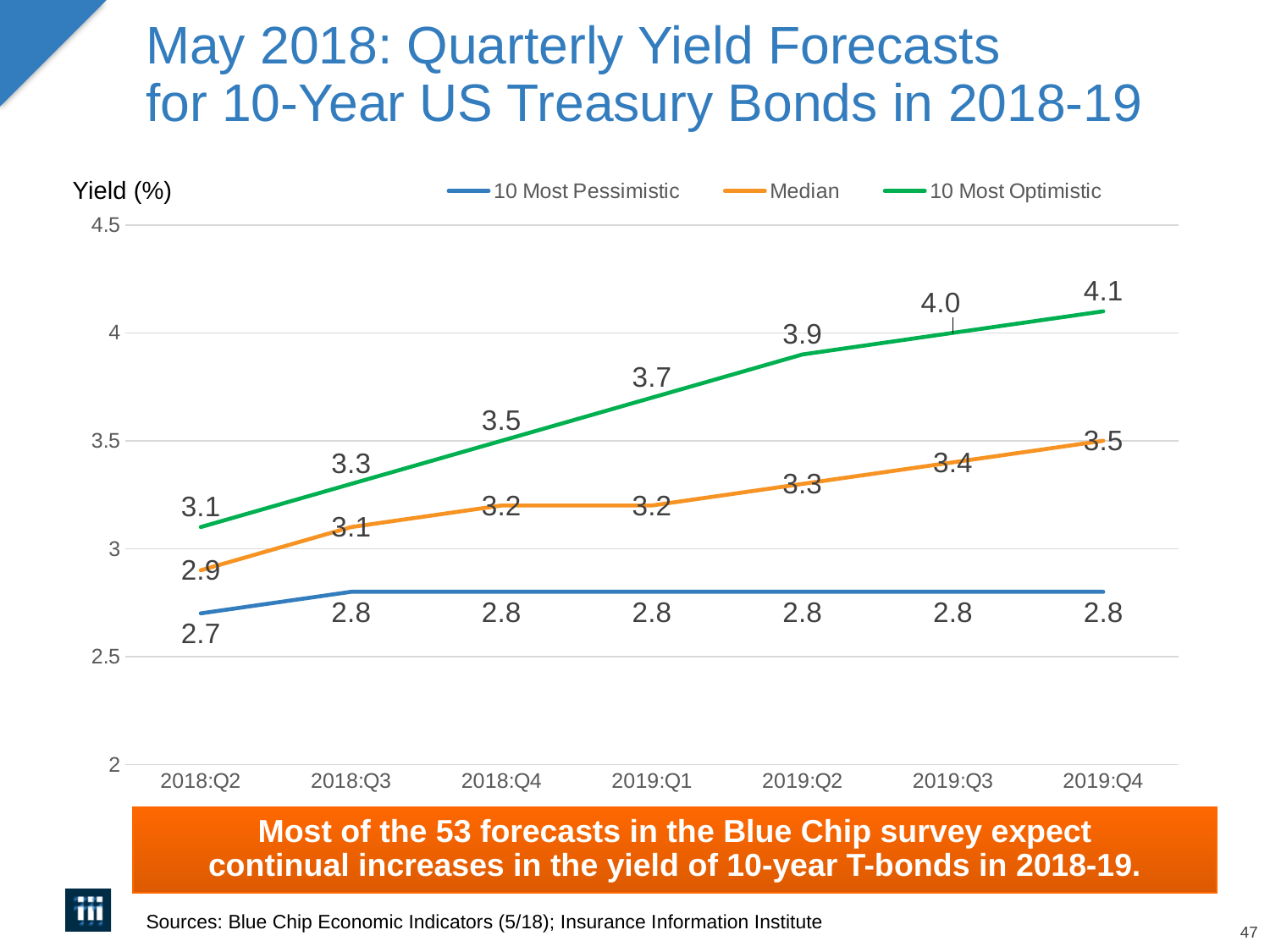
In which quarter is the 10 Most Optimistic forecast highest? 2019:Q4 How many series does the legend list? 3 In which quarter is the Median forecast lowest? 2018:Q2 Which is larger for 2019:Q2, the Median forecast or the 10 Most Optimistic forecast? 10 Most Optimistic How many quarters are shown on the x axis? 7 What is the difference between the 10 Most Optimistic and 10 Most Pessimistic forecasts for 2019:Q4? 1.3 Does the Median forecast rise or fall from 2018:Q2 to 2019:Q4? Rise What is the Median forecast for 2018:Q2? 2.9 What is the 10 Most Optimistic forecast for 2019:Q4? 4.1 What is the 10 Most Pessimistic forecast for 2019:Q3? 2.8 What kind of chart is shown on the slide? Line chart Is the 10 Most Optimistic forecast for 2019:Q3 greater or less than 3.5? greater